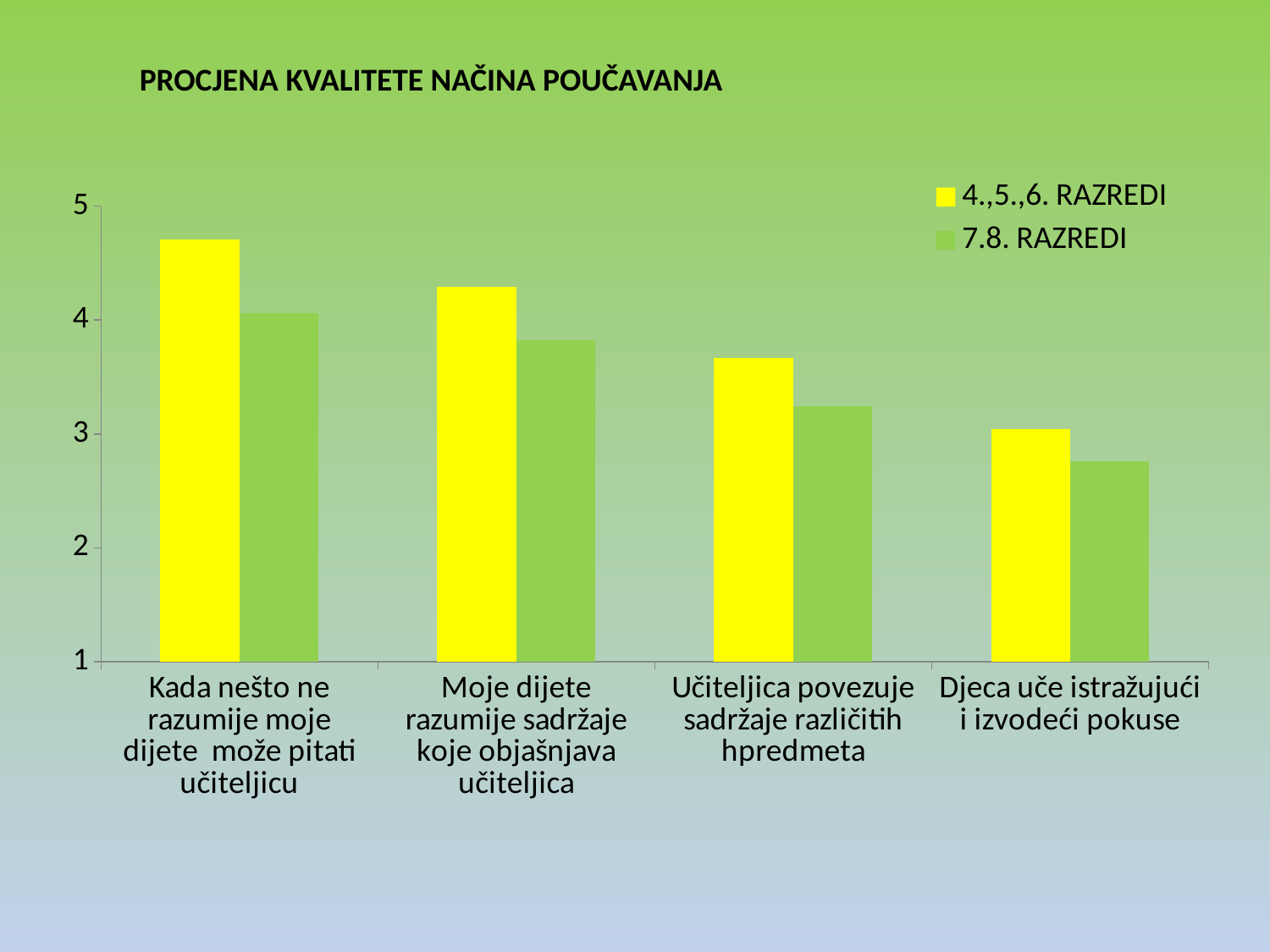
Is the value for 4.,5.,6. RAZREDI in the category 'Kada nešto ne razumije moje dijete može pitati učiteljicu' greater or less than 4? greater Is the value for 4.,5.,6. RAZREDI in the category 'Učiteljica povezuje sadržaje različitih hpredmeta' greater or less than 3? greater How many categories are shown on the x axis? 4 What is the title of the chart? PROCJENA KVALITETE NAČINA POUČAVANJA Is the value for 7.8. RAZREDI in the category 'Moje dijete razumije sadržaje koje objašnjava učiteljica' greater or less than 4? less Which category has the lowest value for the 7.8. RAZREDI series? Djeca uče istražujući i izvodeći pokuse What kind of chart is shown on the slide? bar chart Which category has the highest value for the 4.,5.,6. RAZREDI series? Kada nešto ne razumije moje dijete može pitati učiteljicu How many series does the legend list? 2 Do the values for the 7.8. RAZREDI series rise or fall from left to right along the x axis? fall In the category 'Učiteljica povezuje sadržaje različitih hpredmeta', which series has the larger value, 4.,5.,6. RAZREDI or 7.8. RAZREDI? 4.,5.,6. RAZREDI